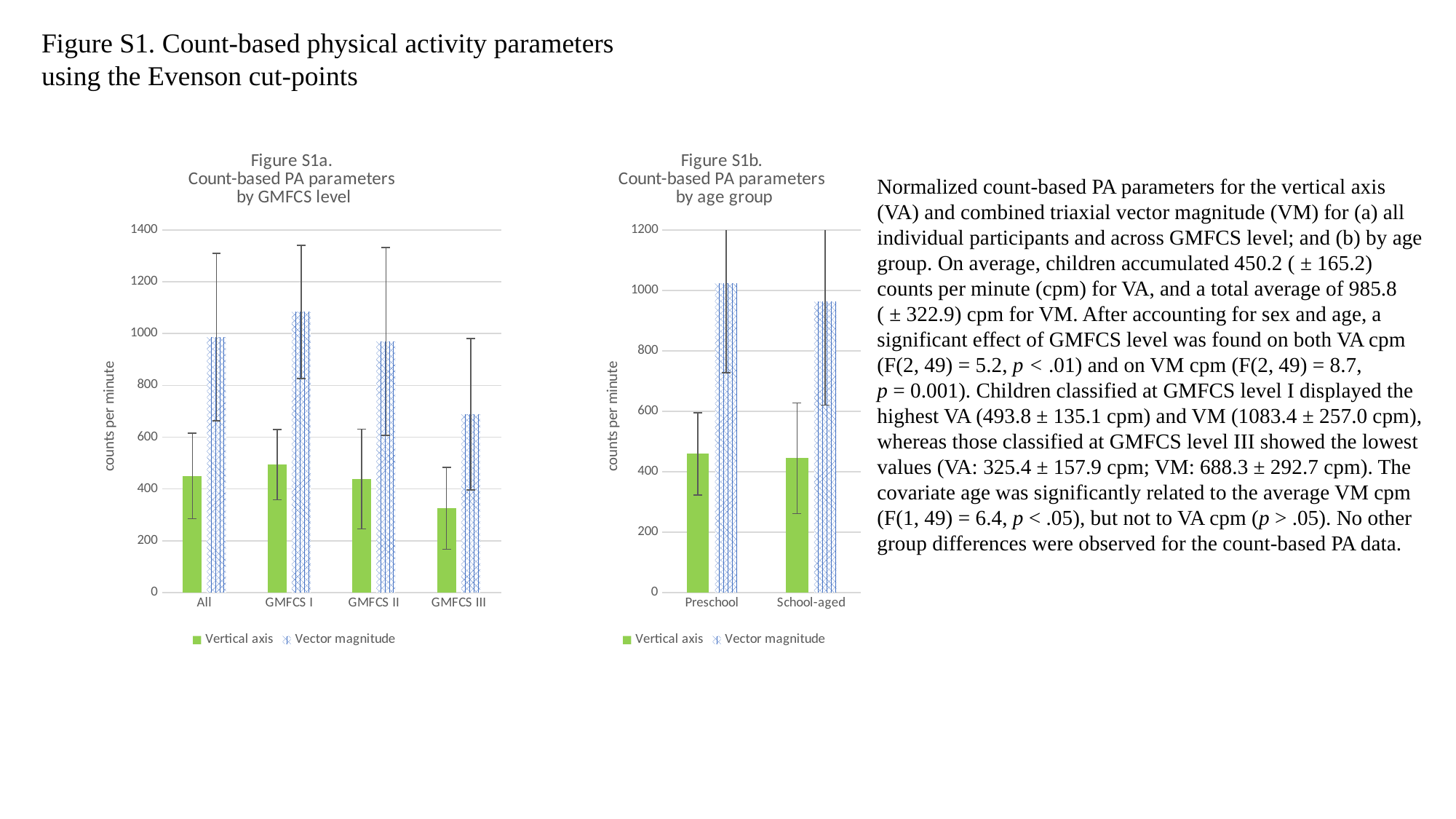
In Figure S1a (by GMFCS level), which category has the lowest Vertical axis value? GMFCS III What is the y-axis label of Figure S1b (by age group)? counts per minute In Figure S1a (by GMFCS level), how many series does the legend list? 2 In Figure S1a (by GMFCS level), which is larger: the Vector magnitude value for All or for GMFCS III? All In Figure S1a (by GMFCS level), is the Vector magnitude value for GMFCS III greater or less than 800? less In Figure S1a (by GMFCS level), which category has the highest Vector magnitude value? GMFCS I What kind of chart is Figure S1a (Count-based PA parameters by GMFCS level)? bar chart In Figure S1b (by age group), which is larger: the Vector magnitude value for Preschool or for School-aged? Preschool In Figure S1b (by age group), is the Vector magnitude value for Preschool greater or less than 800? greater In Figure S1a (by GMFCS level), is the Vertical axis value for GMFCS I greater or less than 400? greater In Figure S1a (by GMFCS level), how many categories are shown on the x axis? 4 In Figure S1b (by age group), how many categories are shown on the x axis? 2